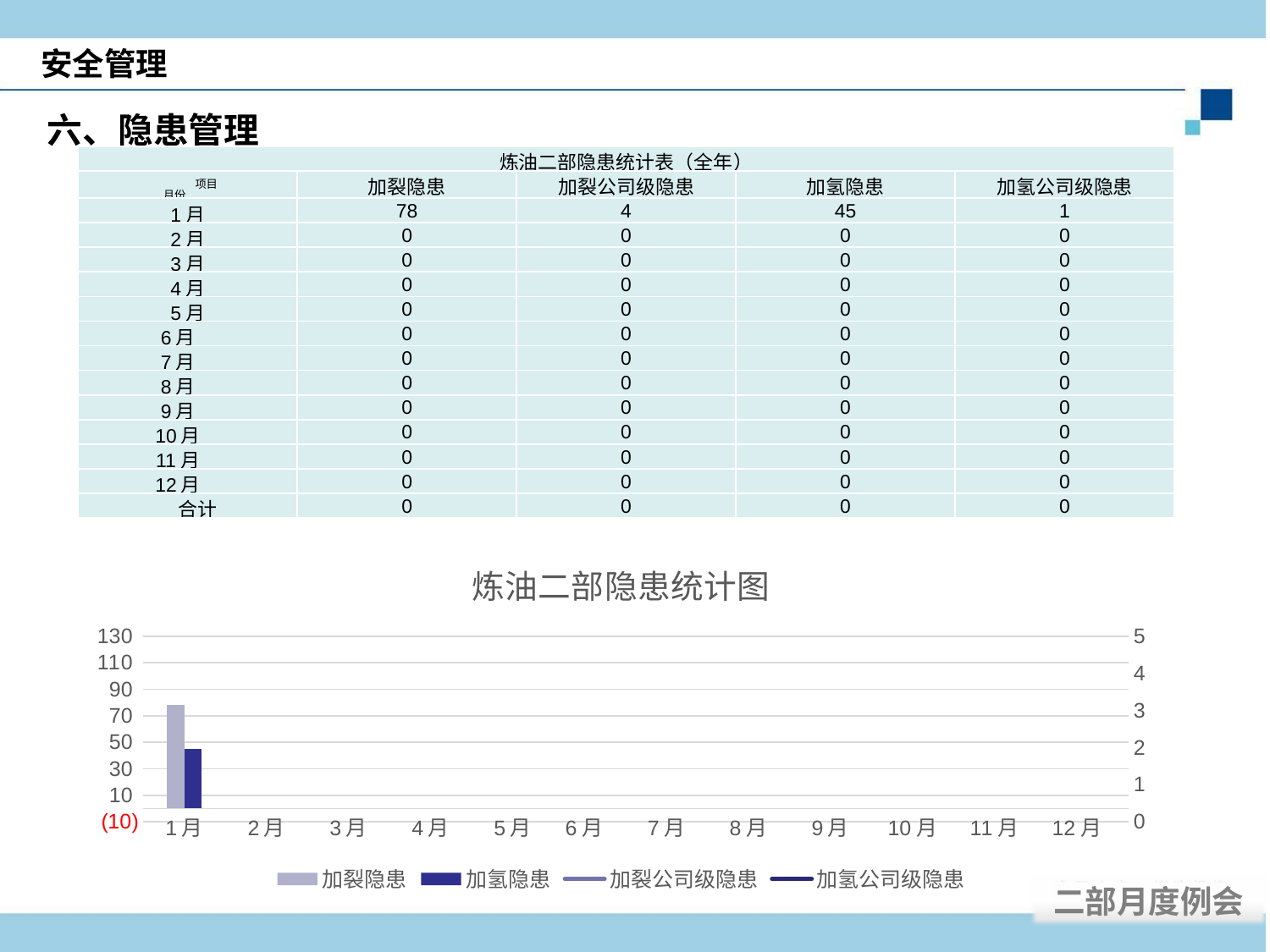
In the 炼油二部隐患统计图 chart, is the 加氢隐患 value for 1月 greater or less than 30? greater According to the table on the slide, what is the 加裂隐患 value for 1月? 78 In the 炼油二部隐患统计图 chart, which month has the highest 加裂隐患 bar? 1月 In the 炼油二部隐患统计图 chart, do the 加裂隐患 bars rise or fall from 1月 to 2月? fall In the 炼油二部隐患统计图 chart, which is larger for 1月: 加裂隐患 or 加氢隐患? 加裂隐患 What type of chart is 炼油二部隐患统计图? combination bar and line chart How many series does the legend of the 炼油二部隐患统计图 chart list? 4 According to the table on the slide, what is the 加氢隐患 value for 1月? 45 How many months are shown on the x axis of the 炼油二部隐患统计图 chart? 12 What is the title of the chart at the bottom of the slide? 炼油二部隐患统计图 In the 炼油二部隐患统计图 chart, is the 加裂隐患 value for 1月 greater or less than 50? greater In the 炼油二部隐患统计图 chart, is the 加裂隐患 value for 1月 greater or less than 90? less